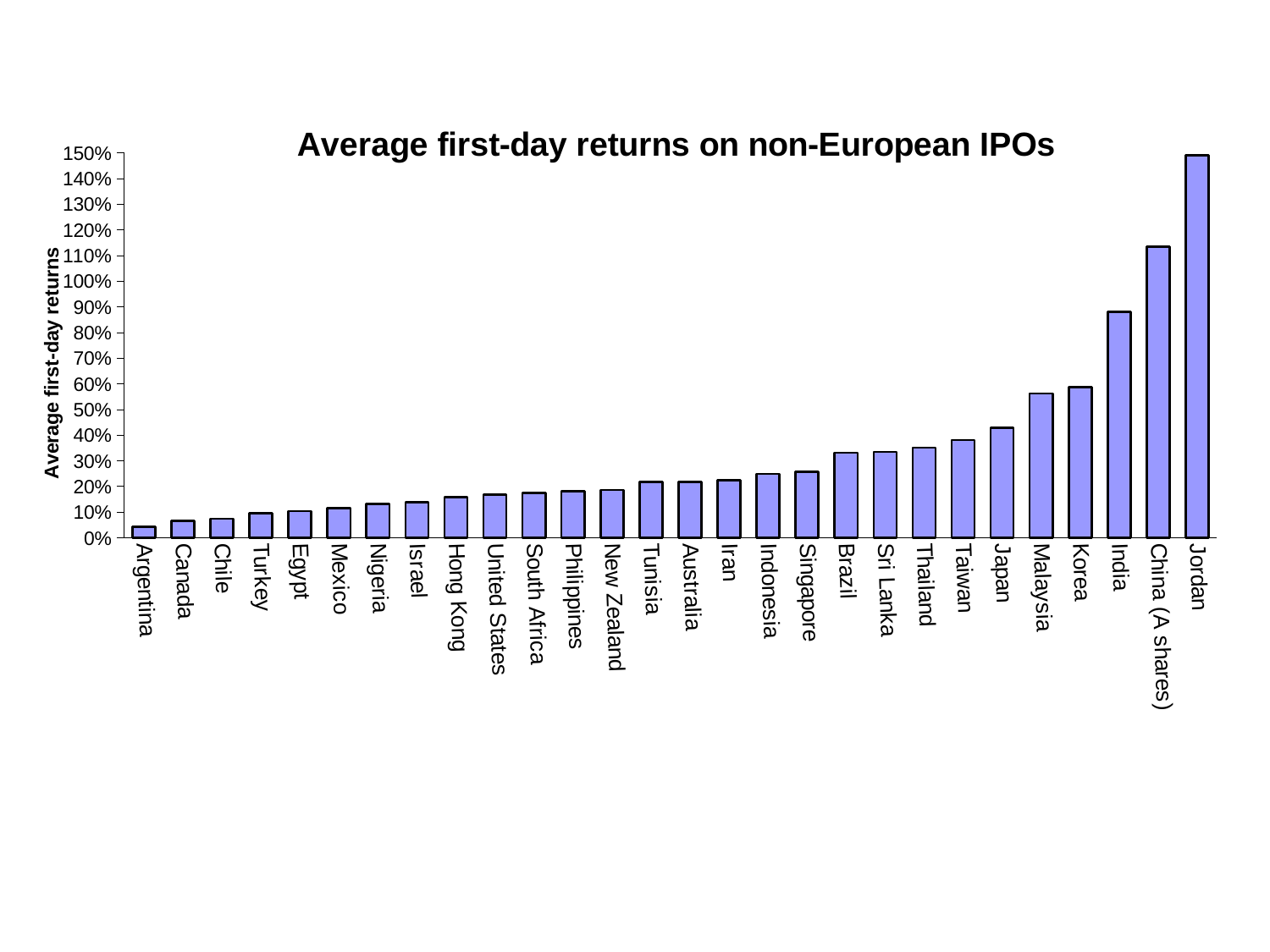
Which country has the lowest average first-day return? Argentina Is the value for Argentina greater or less than 10%? less Which has a higher average first-day return, India or Korea? India What kind of chart is shown on the slide? bar chart How many countries are shown on the x axis of the chart? 28 Is the value for Jordan greater or less than 140%? greater Is the value for Korea greater or less than 50%? greater Do the values rise or fall moving from left to right along the x axis? rise Which country has the highest average first-day return? Jordan What is the title of the chart? Average first-day returns on non-European IPOs